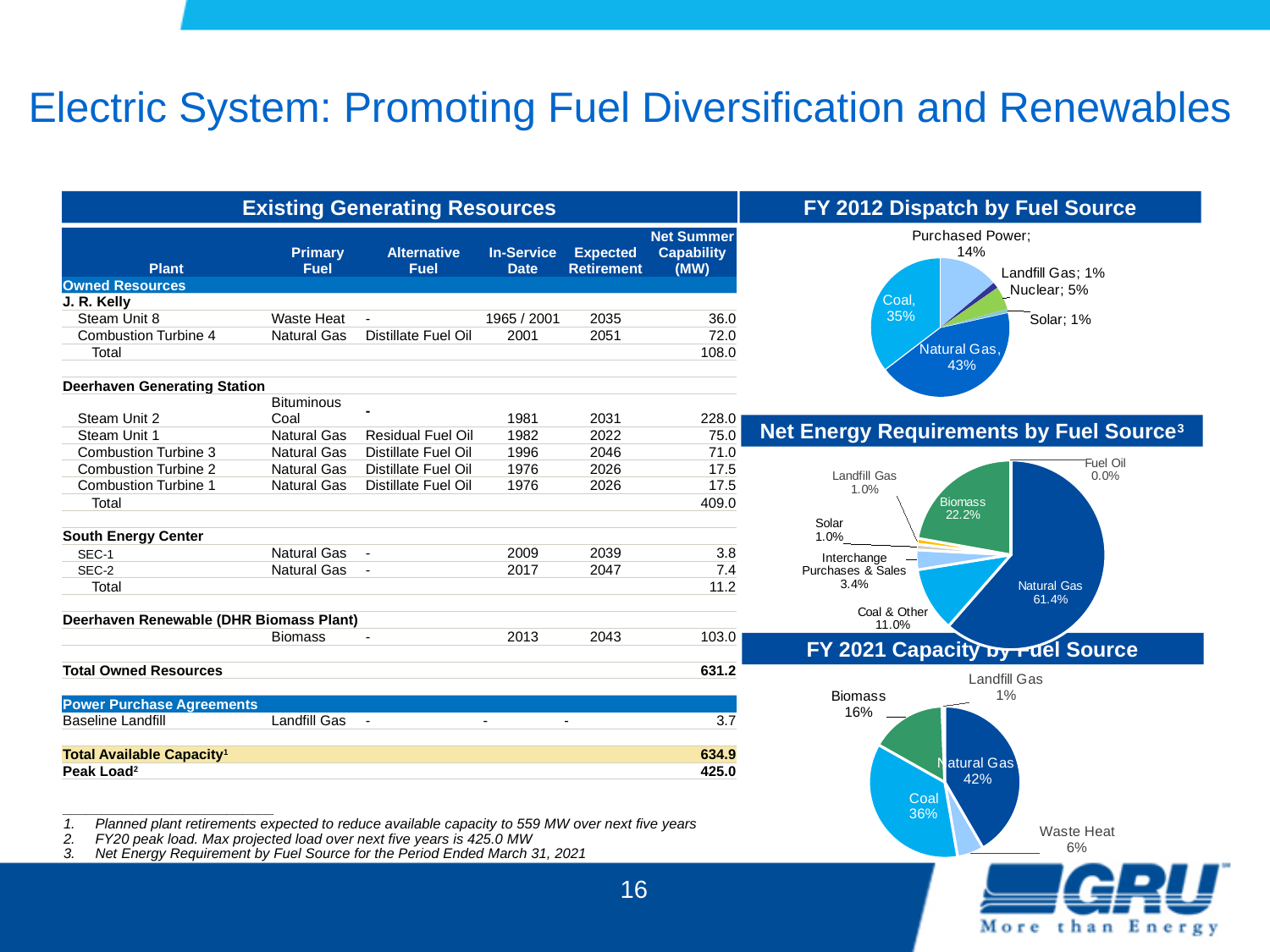
In the FY 2012 Dispatch by Fuel Source chart, which fuel source has the largest share? Natural Gas How many slices does the FY 2012 Dispatch by Fuel Source pie chart have? 6 In the Net Energy Requirements by Fuel Source chart, what share is Biomass? 22.2% In the FY 2012 Dispatch by Fuel Source chart, what share is Purchased Power? 14% In the FY 2012 Dispatch by Fuel Source chart, what is the difference between the Natural Gas and Coal shares? 8% In the FY 2021 Capacity by Fuel Source chart, what is the difference between the Biomass and Waste Heat shares? 10% What type of chart is the FY 2021 Capacity by Fuel Source chart? Pie chart In the FY 2012 Dispatch by Fuel Source chart, what share is Natural Gas? 43% In the Net Energy Requirements by Fuel Source chart, what share is Coal & Other? 11.0% In the Net Energy Requirements by Fuel Source chart, which is larger, Biomass or Interchange Purchases & Sales? Biomass In the Net Energy Requirements by Fuel Source chart, which fuel source has the smallest share? Fuel Oil In the FY 2021 Capacity by Fuel Source chart, what share is Coal? 36%